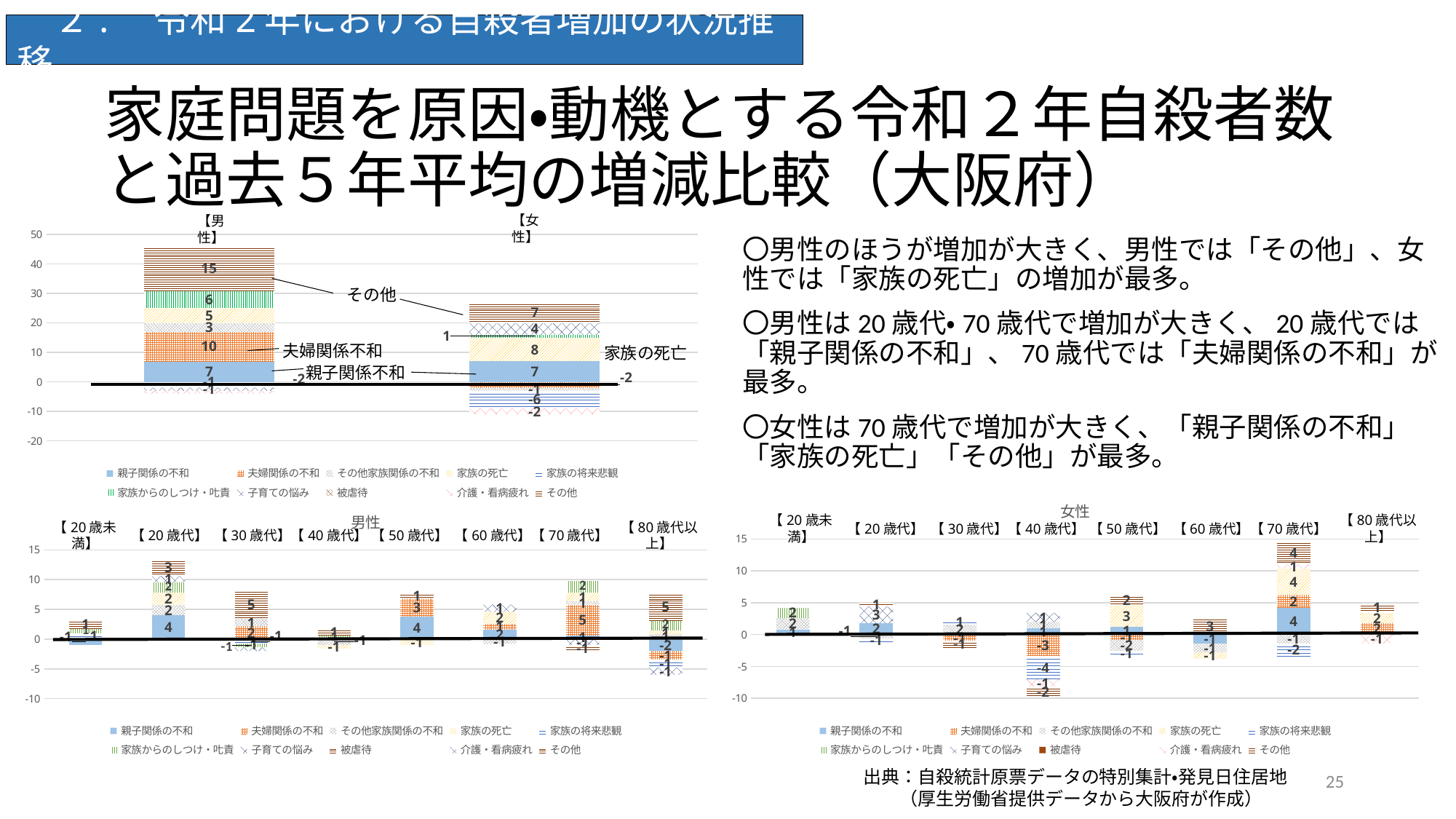
How many age categories are shown on the x axis of the bottom-right 女性 chart? 8 What kind of chart is the top-left chart comparing 【男性】 and 【女性】? bar chart In the top-left chart, which has the larger その他 value, 【男性】 or 【女性】? 【男性】 In the bottom-left 男性 chart, what is the value of 親子関係の不和 for 【20歳代】? 4 In the top-left chart, what is the value of the 家族の死亡 segment for 【女性】? 8 In the bottom-right 女性 chart, what is the value of 親子関係の不和 for 【70歳代】? 4 In the bottom-left 男性 chart, what is the value of その他 for 【30歳代】? 5 In the top-left chart, what is the difference between the その他 value for 【男性】 and the その他 value for 【女性】? 8 In the top-left chart, what is the value of the 親子関係不和 segment for 【女性】? 7 In the top-left chart, what is the value of the 夫婦関係不和 segment for 【男性】? 10 In the top-left chart, what is the value of the その他 segment for 【男性】? 15 How many series does the legend of the top-left chart list? 10